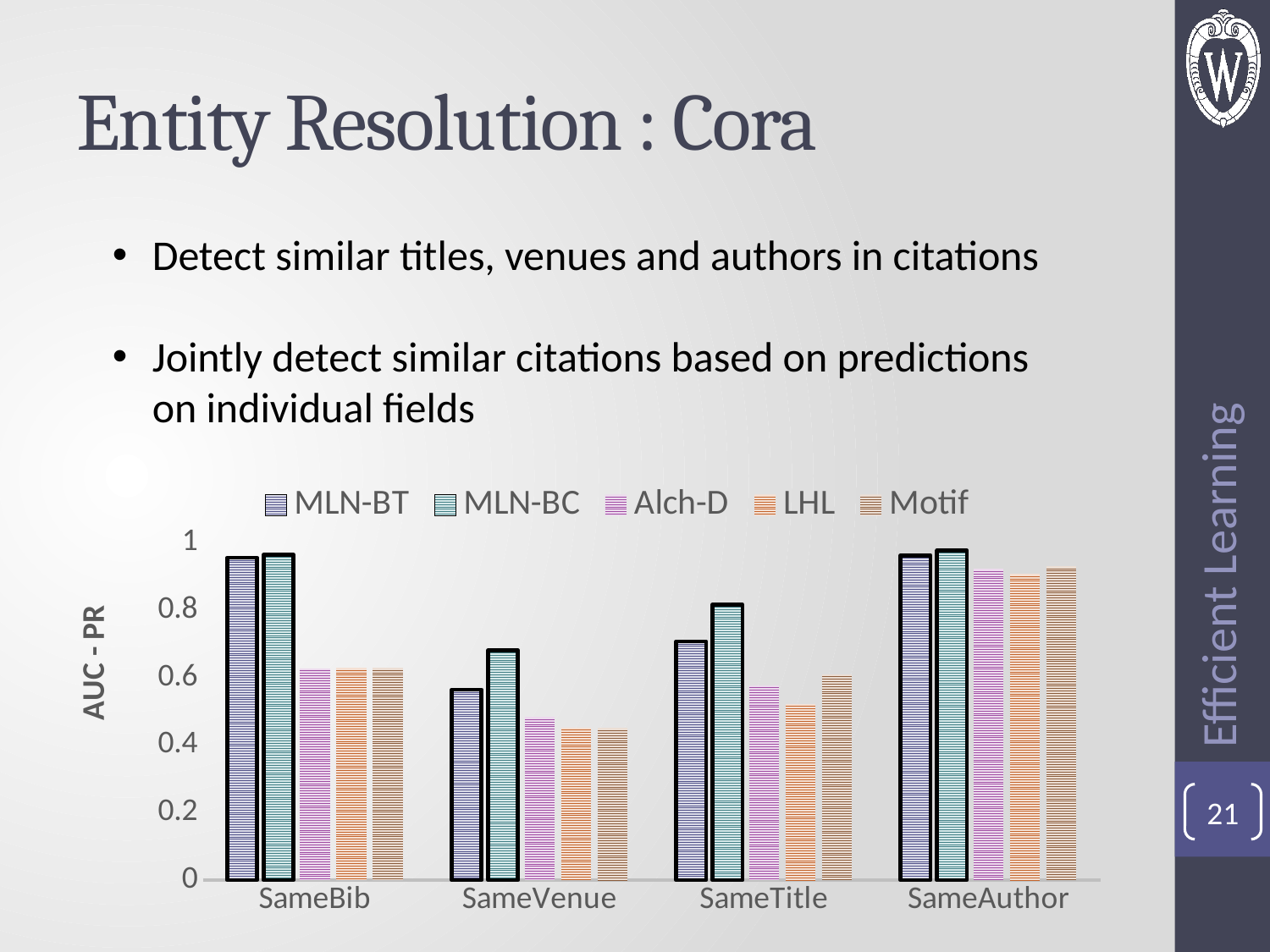
Which series has the lowest value for SameTitle? LHL Is the LHL value for SameVenue greater or less than 0.6? less What kind of chart is shown on the slide? bar chart Is the Motif value for SameTitle greater or less than 0.8? less Is the MLN-BC value for SameVenue greater or less than 0.6? greater Which series has the highest value for SameVenue? MLN-BC How many categories are shown on the x axis of the chart? 4 For which category is the MLN-BT value the lowest? SameVenue How many series does the legend of the chart list? 5 What is the label of the vertical axis of the chart? AUC - PR For SameTitle, which is larger: the MLN-BT value or the MLN-BC value? MLN-BC